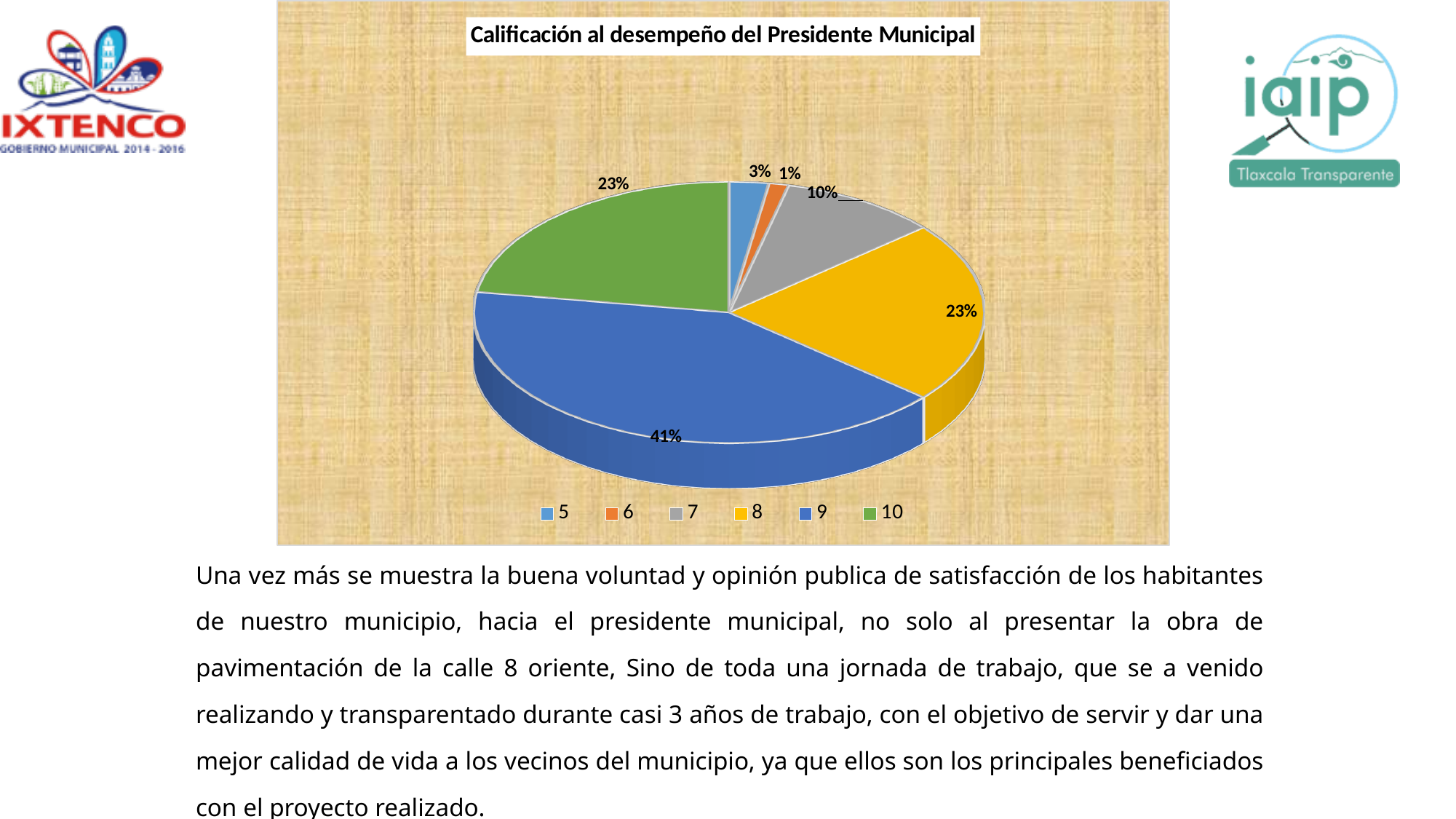
What percentage of the pie corresponds to the rating 10? 23% Which rating has the smallest share of the pie? 6 Which rating has the largest share of the pie? 9 What is the title of the chart? Calificación al desempeño del Presidente Municipal What percentage of the pie corresponds to the rating 9? 41% What percentage of the pie corresponds to the rating 7? 10% Which has a larger share of the pie, rating 7 or rating 5? 7 What is the difference in percentage points between the share for rating 9 and the share for rating 8? 18 How many categories does the legend of the pie chart list? 6 What percentage of the pie corresponds to the rating 6? 1% What percentage of the pie corresponds to the rating 5? 3% What kind of chart is shown on the slide? Pie chart